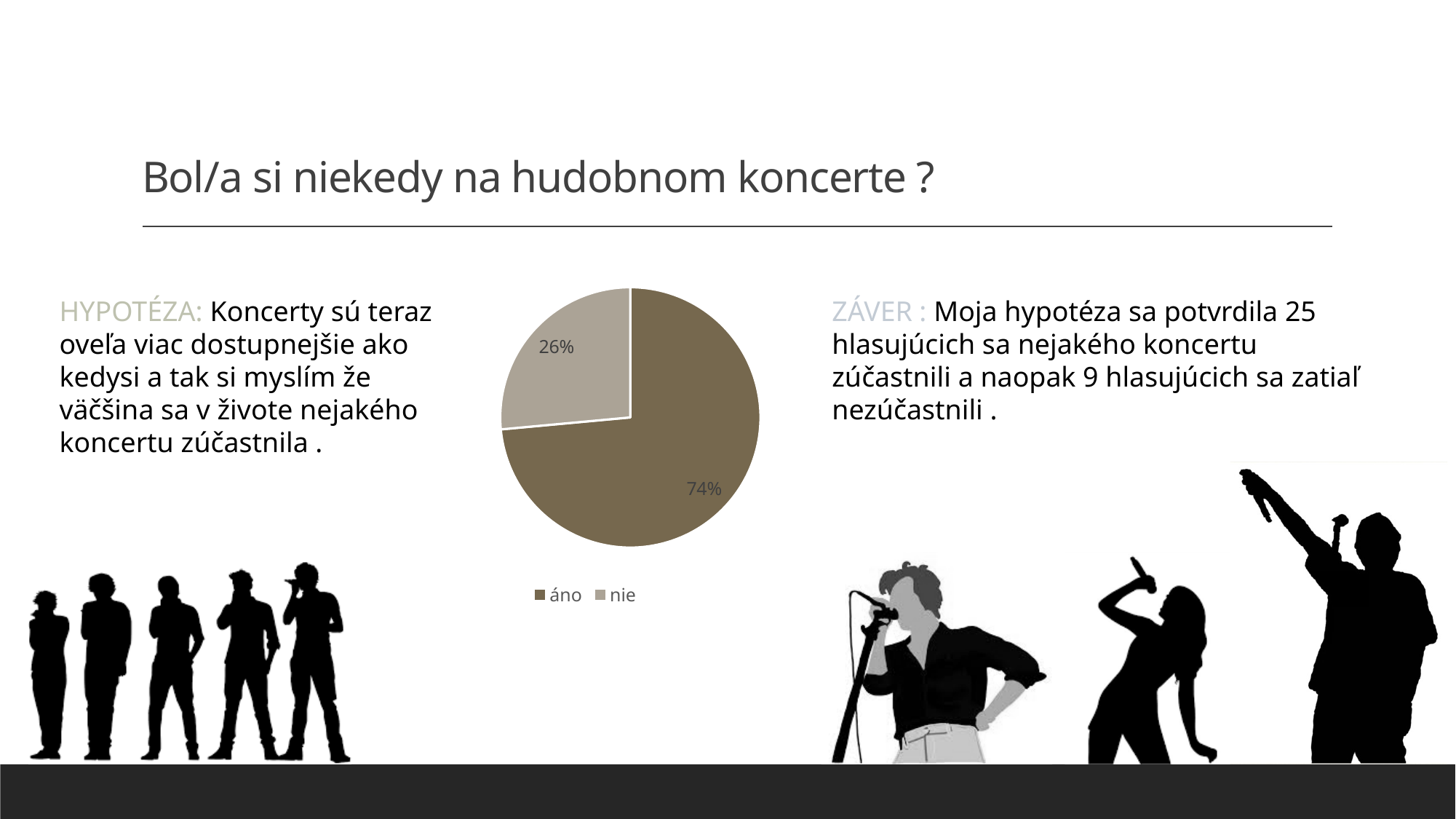
How many slices does the pie chart have? 2 Which slice of the pie is the largest? áno What share of the pie does the "nie" slice represent? 26% Is the share for "nie" greater or less than 50%? less What are the two legend entries of the pie chart? áno, nie Which is larger, the "áno" slice or the "nie" slice? áno Which legend entry is shown in the darker brown colour? áno Which slice of the pie is the smallest? nie What share of the pie does the "áno" slice represent? 74% What kind of chart is shown on the slide? pie chart How many entries does the legend list? 2 What is the difference in percentage points between the "áno" and "nie" slices? 48